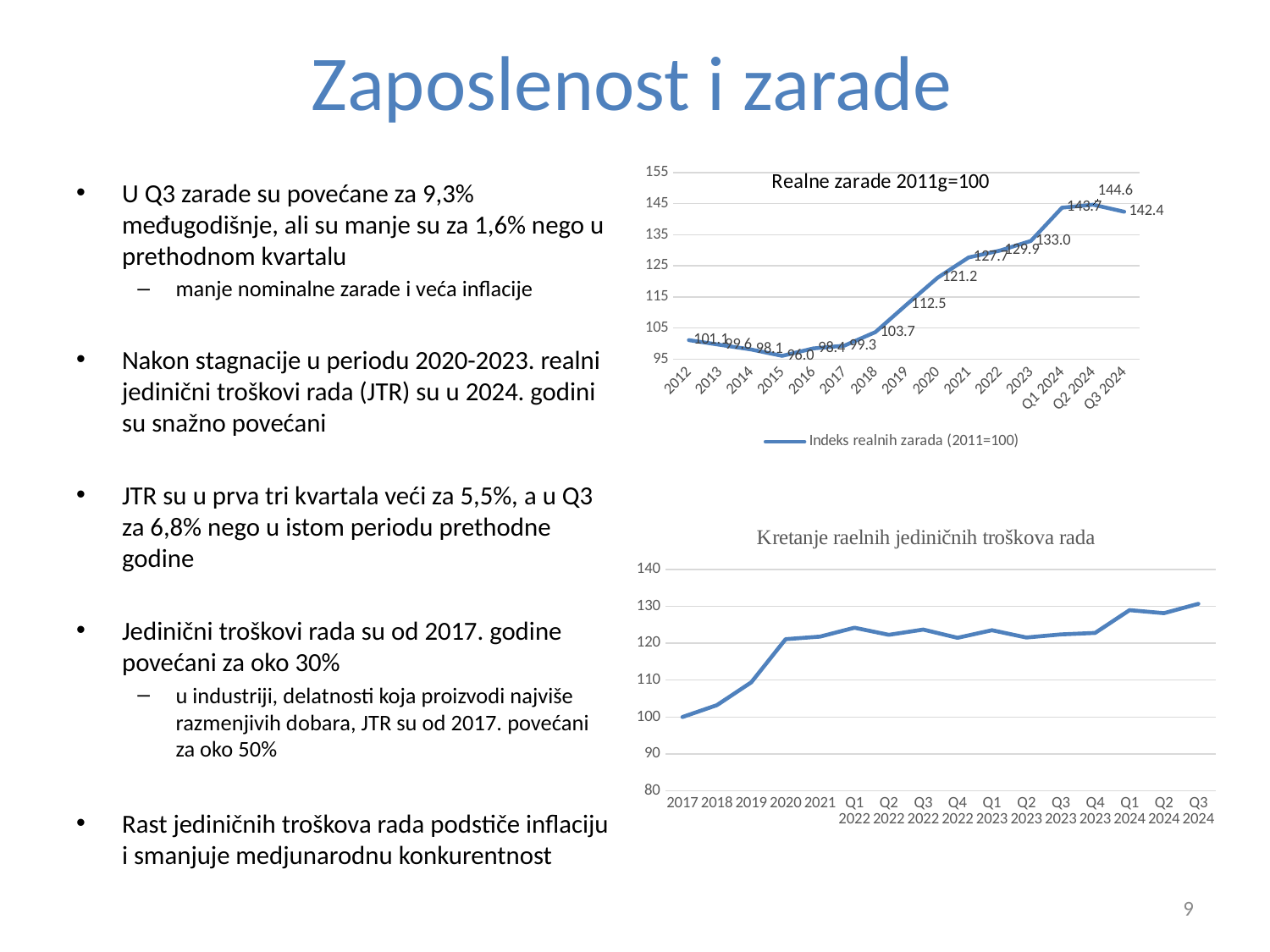
In the bottom chart 'Kretanje raelnih jediničnih troškova rada', which period has the highest value? Q3 2024 In the top chart 'Realne zarade 2011g=100', which year has the lowest value? 2015 What type of chart is the bottom chart 'Kretanje raelnih jediničnih troškova rada'? line chart In the top chart 'Realne zarade 2011g=100', what is the value for Q3 2024? 142.4 In the bottom chart 'Kretanje raelnih jediničnih troškova rada', is the value for Q1 2024 greater or less than 120? greater In the top chart 'Realne zarade 2011g=100', which period has the highest value? Q2 2024 In the top chart 'Realne zarade 2011g=100', what is the value for 2019? 112.5 In the top chart 'Realne zarade 2011g=100', how many data points are plotted? 15 In the top chart 'Realne zarade 2011g=100', what is the legend entry for the series? Indeks realnih zarada (2011=100) In the bottom chart 'Kretanje raelnih jediničnih troškova rada', how many periods are shown on the x axis? 16 In the top chart 'Realne zarade 2011g=100', what is the difference between the values for 2023 and 2020? 11.8 In the top chart 'Realne zarade 2011g=100', what is the value for 2015? 96.0